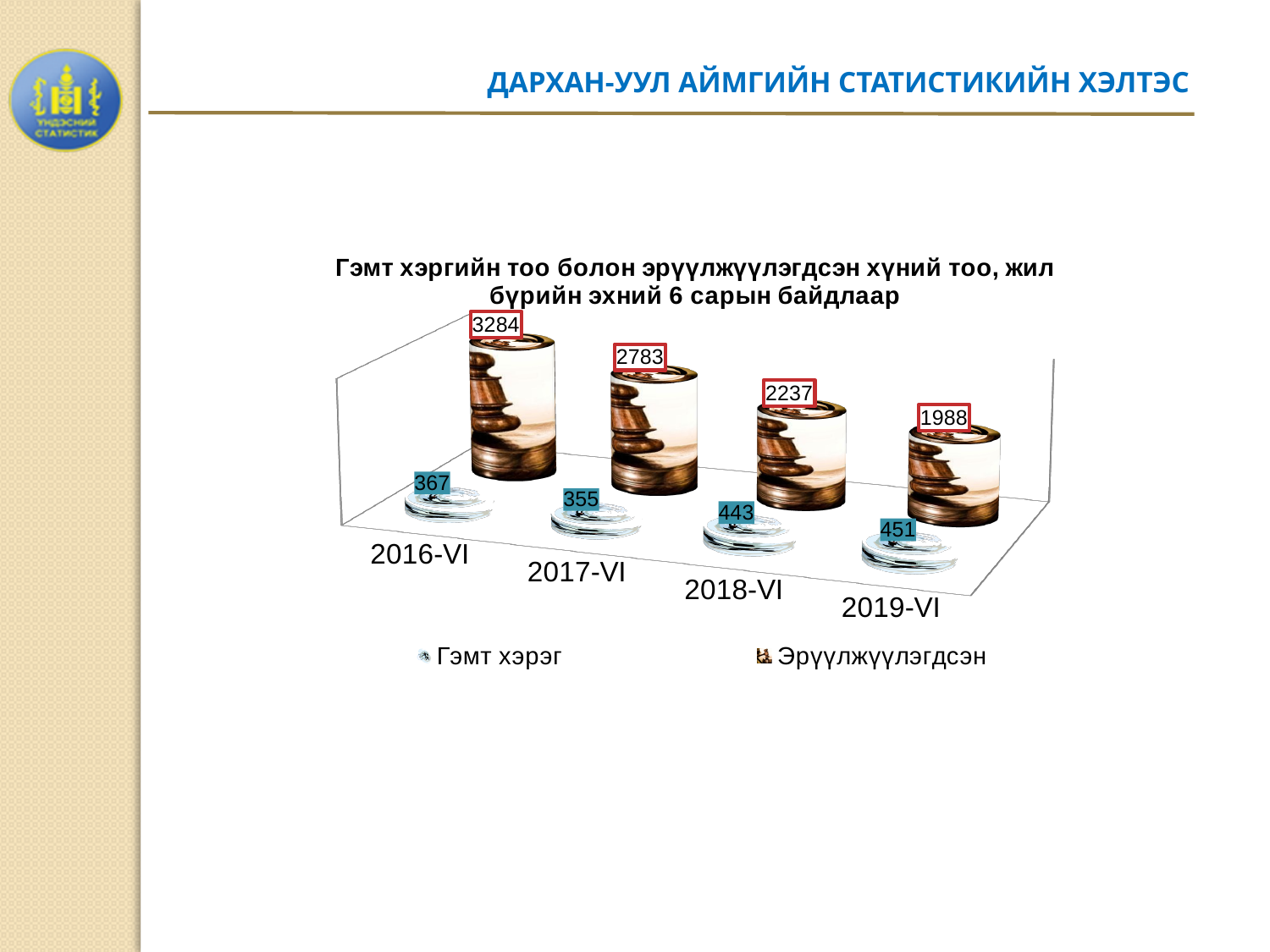
What is the value for Эрүүлжүүлэгдсэн in 2019-VI? 1988 What is the value for Гэмт хэрэг in 2017-VI? 355 In which year is the Эрүүлжүүлэгдсэн value highest? 2016-VI How many years are shown on the x axis? 4 How many series does the legend list? 2 What kind of chart is this? Bar chart In which year is the Гэмт хэрэг value lowest? 2017-VI What is the value for Эрүүлжүүлэгдсэн in 2016-VI? 3284 Which is larger: the Гэмт хэрэг value for 2019-VI or for 2016-VI? 2019-VI What is the difference between the Эрүүлжүүлэгдсэн values for 2016-VI and 2019-VI? 1296 Does the Эрүүлжүүлэгдсэн series rise or fall from 2016-VI to 2019-VI? Fall What is the value for Гэмт хэрэг in 2018-VI? 443